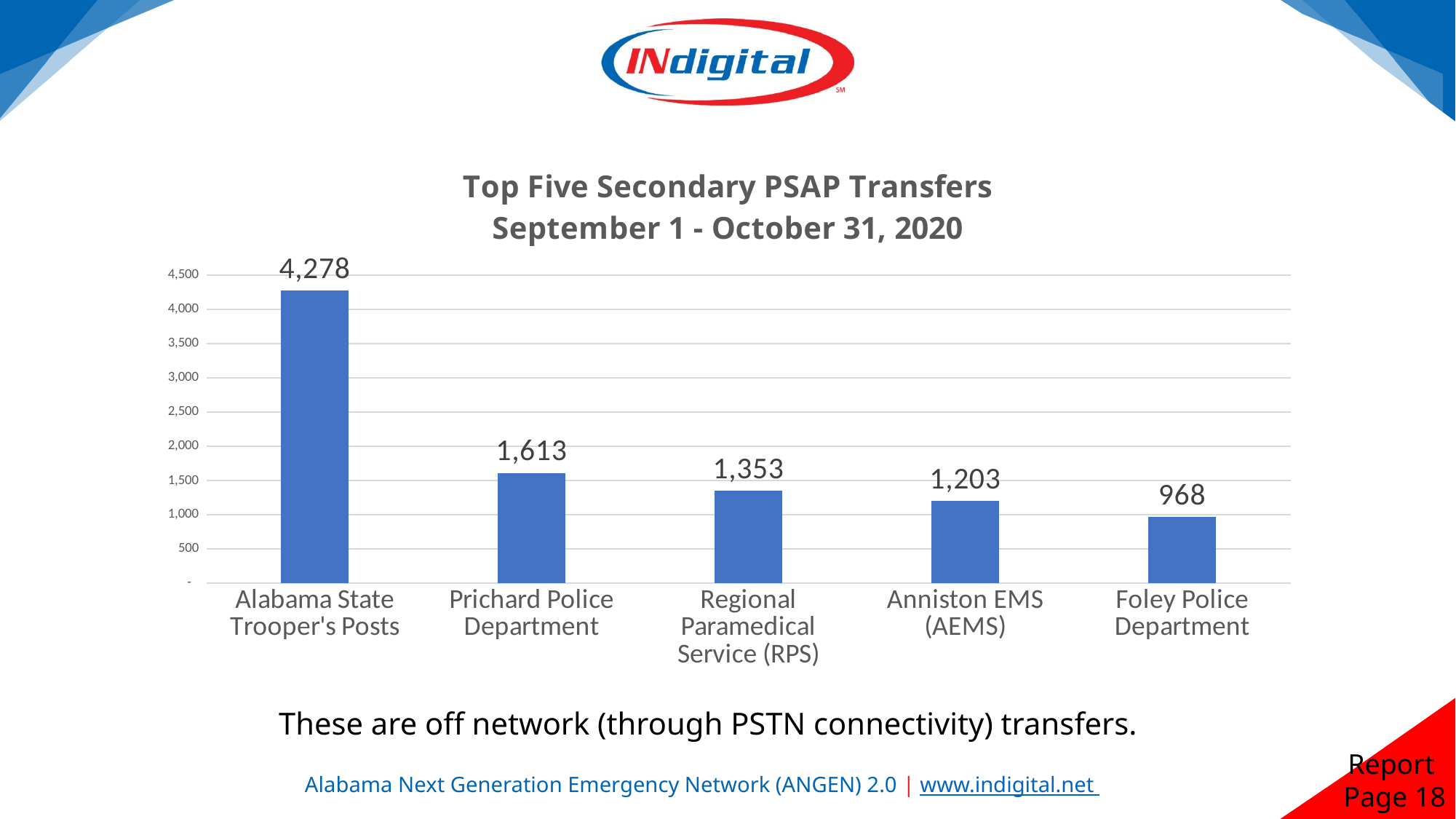
What kind of chart is shown on the slide? Bar chart What is the difference between the values for Alabama State Trooper's Posts and Prichard Police Department? 2,665 How many categories are shown in the chart? 5 What is the value for Alabama State Trooper's Posts? 4,278 What is the value for Prichard Police Department? 1,613 What is the value for Regional Paramedical Service (RPS)? 1,353 Which category has the lowest value? Foley Police Department Which category has the highest value? Alabama State Trooper's Posts What is the title of the chart? Top Five Secondary PSAP Transfers September 1 - October 31, 2020 Which is larger, the value for Regional Paramedical Service (RPS) or Anniston EMS (AEMS)? Regional Paramedical Service (RPS) What is the value for Anniston EMS (AEMS)? 1,203 What is the value for Foley Police Department? 968